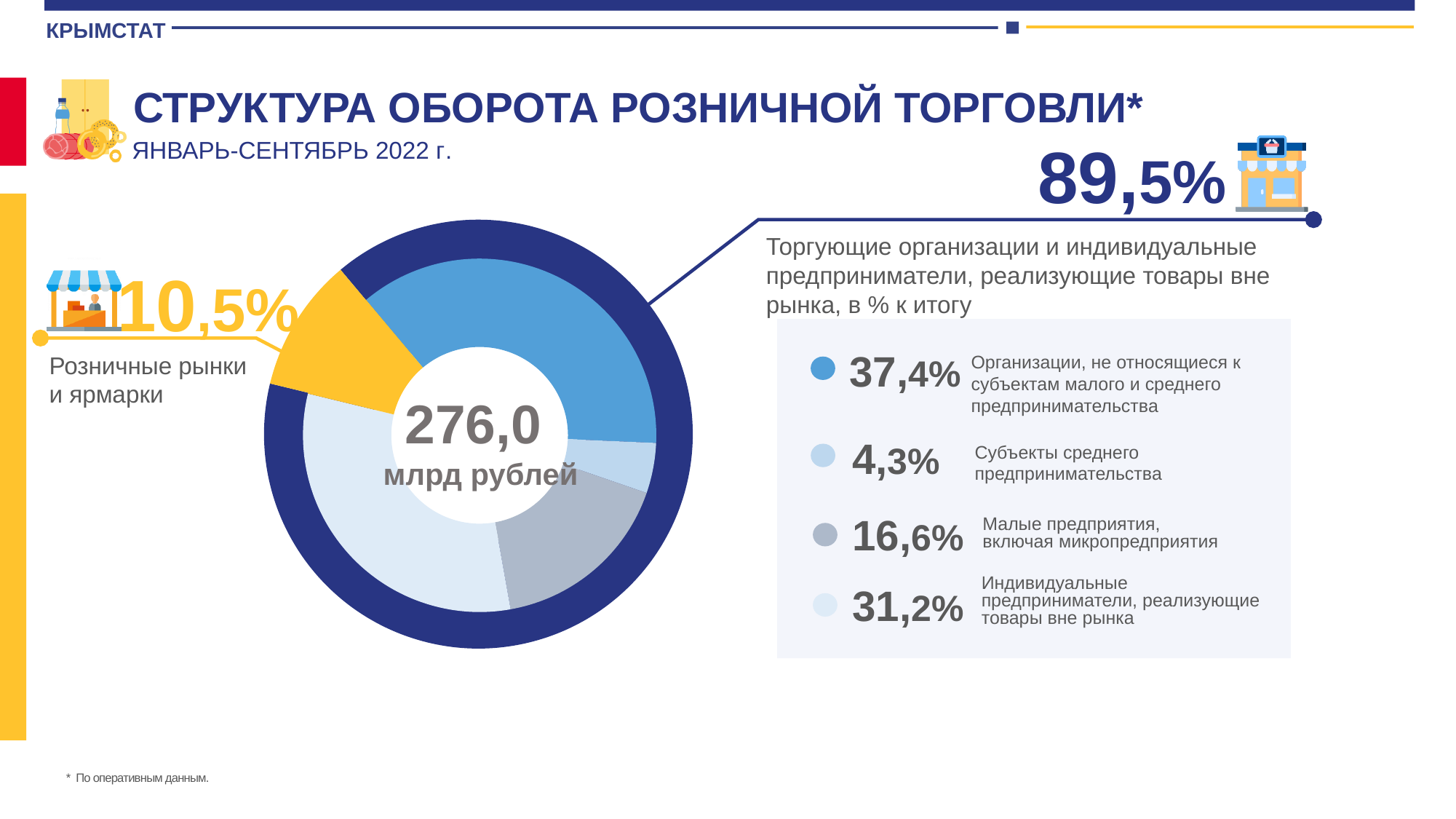
What is the total retail trade turnover shown in the centre of the donut chart? 276,0 млрд рублей What share is shown for medium-sized enterprises (Субъекты среднего предпринимательства)? 4,3% What is the difference in percentage points between the share of organizations not classified as SMEs (37,4%) and individual entrepreneurs selling outside markets (31,2%)? 6,2 What kind of chart is shown on the slide? Pie (donut) chart What share is shown for individual entrepreneurs selling goods outside markets (Индивидуальные предприниматели, реализующие товары вне рынка)? 31,2% What share is shown for organizations not classified as small and medium enterprises (Организации, не относящиеся к субъектам малого и среднего предпринимательства)? 37,4% What share of retail trade turnover is attributed to retail markets and fairs (Розничные рынки и ярмарки)? 10,5% Which category in the breakdown of trading organizations and individual entrepreneurs has the largest share? Организации, не относящиеся к субъектам малого и среднего предпринимательства Which period does the chart cover, according to the subtitle? Январь-сентябрь 2022 г. Which category in the breakdown of trading organizations and individual entrepreneurs has the smallest share? Субъекты среднего предпринимательства What share of retail trade turnover is attributed to trading organizations and individual entrepreneurs selling goods outside markets? 89,5% What share is shown for small enterprises including micro-enterprises (Малые предприятия, включая микропредприятия)? 16,6%